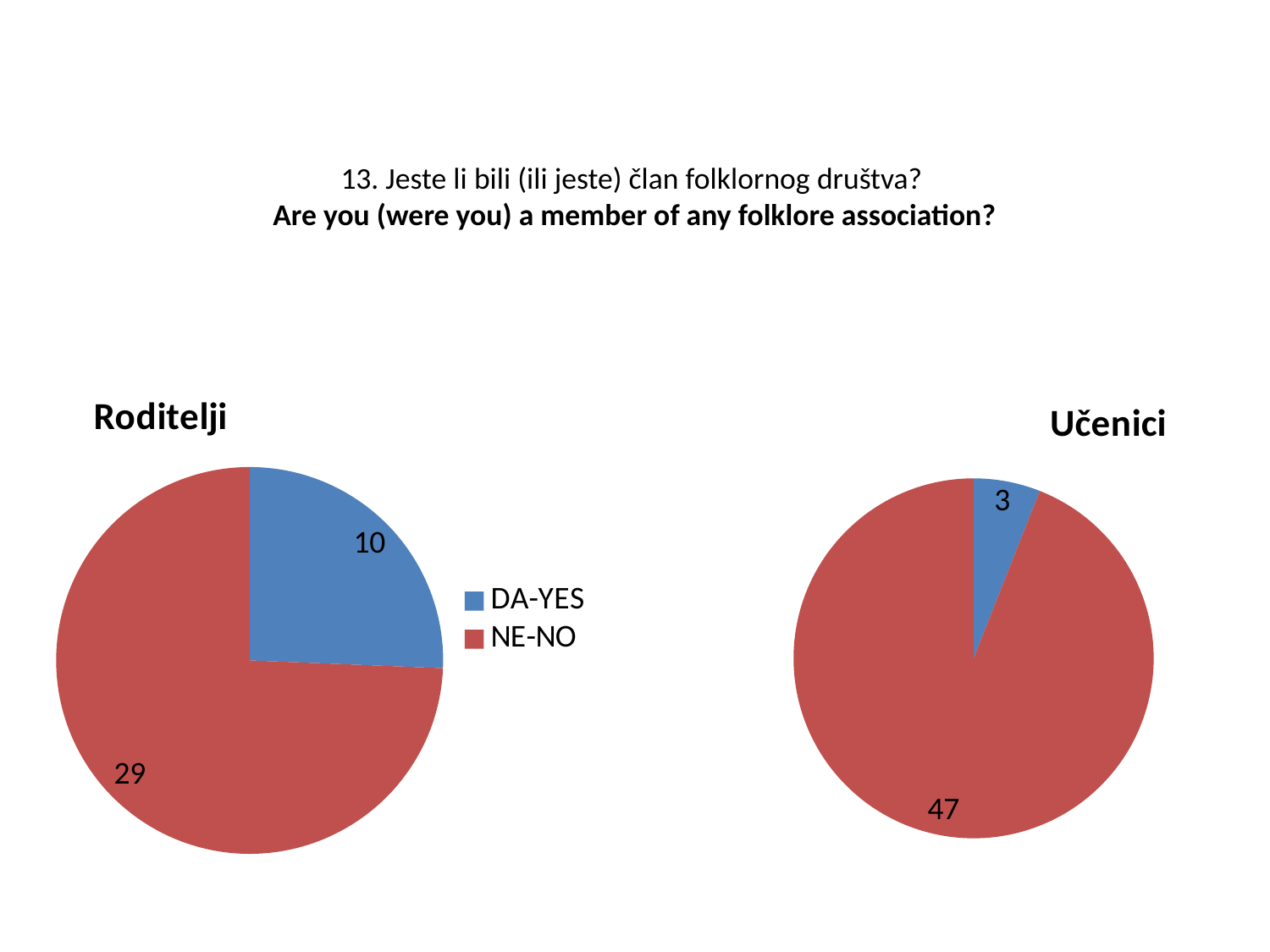
In the Učenici chart, what is the value for DA-YES? 3 In the Roditelji chart, what is the value for DA-YES? 10 What colour represents NE-NO in the charts? Red In the Roditelji chart, what is the value for NE-NO? 29 In the Učenici chart, what is the value for NE-NO? 47 How many categories does the legend list? 2 Which is larger: the DA-YES value in the Roditelji chart or the DA-YES value in the Učenici chart? Roditelji What type of chart is the Roditelji chart? Pie chart In the Učenici chart, which category has the smallest slice? DA-YES In the Roditelji chart, which category has the largest slice? NE-NO In the Učenici chart, what is the difference between the NE-NO and DA-YES values? 44 In the Roditelji chart, what is the difference between the NE-NO and DA-YES values? 19